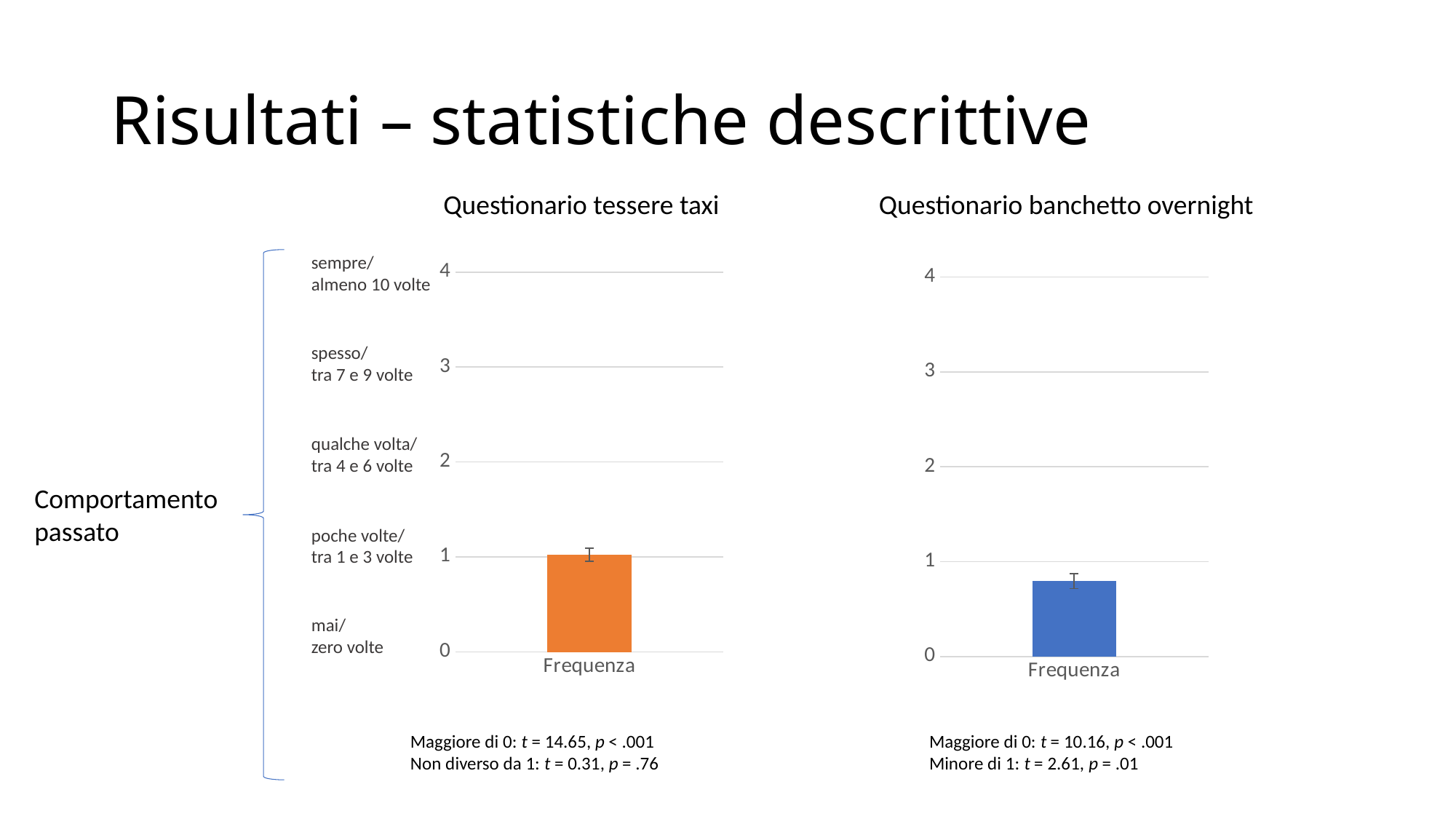
What kind of chart is the 'Questionario tessere taxi' chart? bar chart What colour is the bar in the 'Questionario banchetto overnight' chart? blue In the 'Questionario banchetto overnight' chart, is the value for Frequenza greater or less than 1? less How many bars are plotted in the 'Questionario banchetto overnight' chart? 1 Which chart shows the higher Frequenza bar, 'Questionario tessere taxi' or 'Questionario banchetto overnight'? Questionario tessere taxi What is the category label on the x axis of the 'Questionario tessere taxi' chart? Frequenza What is the highest tick value shown on the y axis of the 'Questionario banchetto overnight' chart? 4 What kind of chart is the 'Questionario banchetto overnight' chart? bar chart How many bars are plotted in the 'Questionario tessere taxi' chart? 1 In the 'Questionario banchetto overnight' chart, is the value for Frequenza greater or less than 2? less In the 'Questionario tessere taxi' chart, is the value for Frequenza greater or less than 2? less